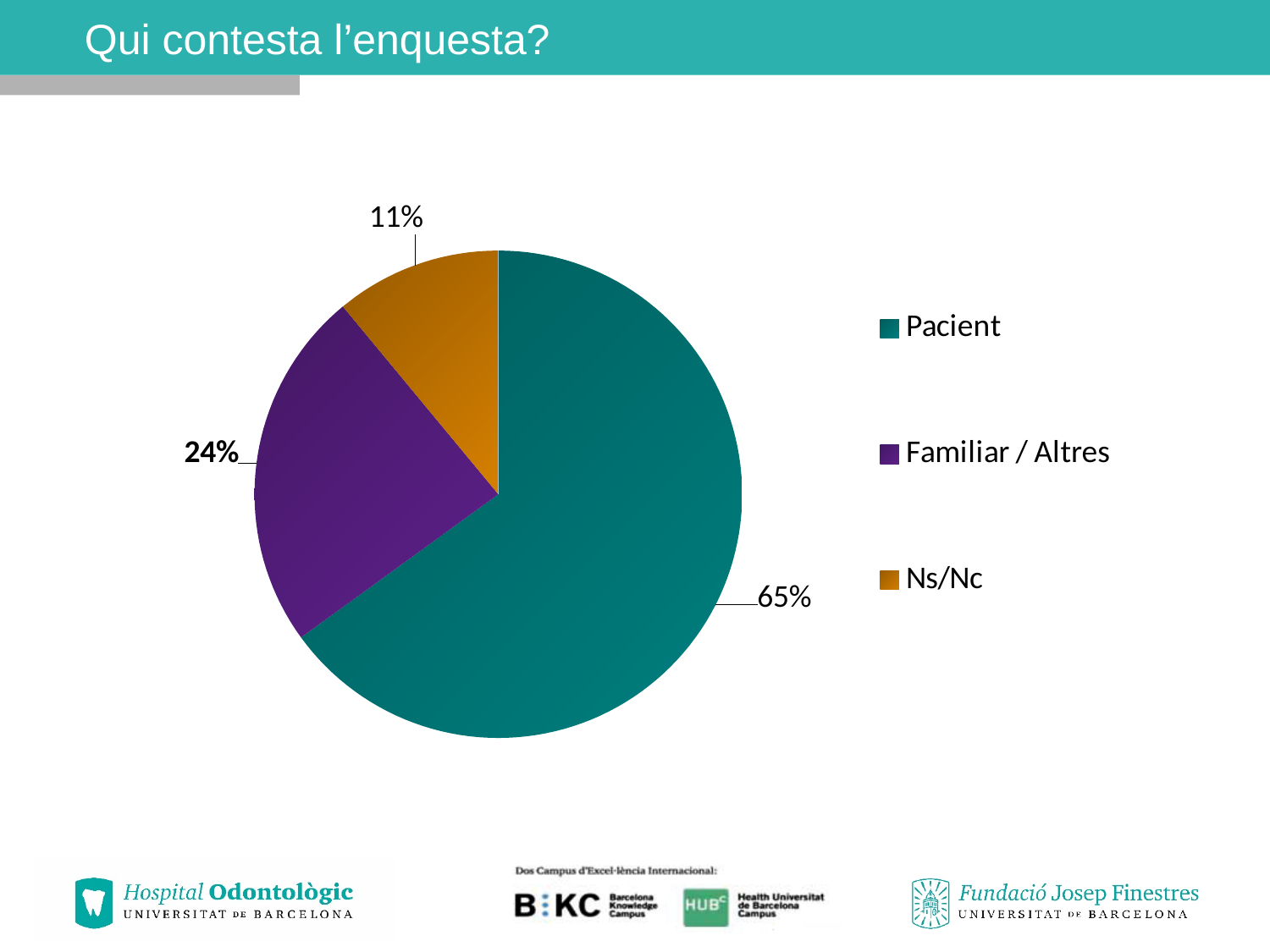
What share of the pie does Pacient represent? 65% Which category has the smallest slice of the pie? Ns/Nc Which is larger, the slice for Familiar / Altres or the slice for Ns/Nc? Familiar / Altres What share of the pie does Ns/Nc represent? 11% What is the title of the slide containing the chart? Qui contesta l'enquesta? Which category has the largest slice of the pie? Pacient Which legend entry is shown in orange? Ns/Nc What kind of chart is shown on the slide? Pie chart What is the difference in percentage points between Familiar / Altres and Ns/Nc? 13 What share of the pie does Familiar / Altres represent? 24% How many slices does the pie chart have? 3 What is the difference in percentage points between Pacient and Familiar / Altres? 41